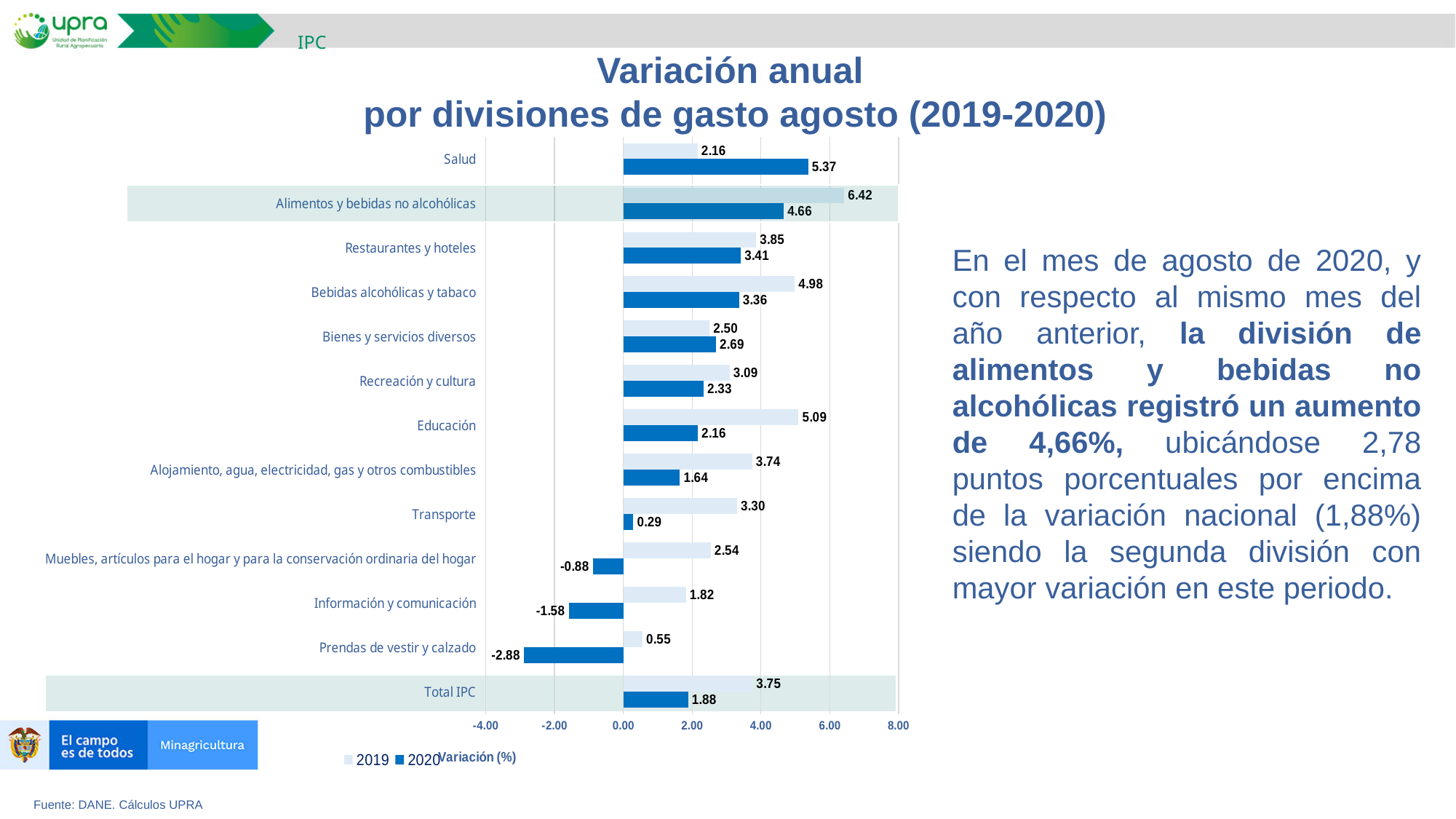
What kind of chart is shown on the slide? Bar chart How many series does the legend list? 2 What is the 2020 value for Salud? 5.37 Which category has the lowest 2020 value? Prendas de vestir y calzado Which category has the highest 2020 value? Salud Which is larger for Educación, the 2019 value or the 2020 value? 2019 What is the difference between the 2020 value for Alimentos y bebidas no alcohólicas and the 2020 value for Total IPC? 2.78 Which category has the highest 2019 value? Alimentos y bebidas no alcohólicas How many categories are shown on the chart? 13 What is the 2020 value for Total IPC? 1.88 What is the label of the horizontal axis? Variación (%) What is the 2019 value for Alimentos y bebidas no alcohólicas? 6.42